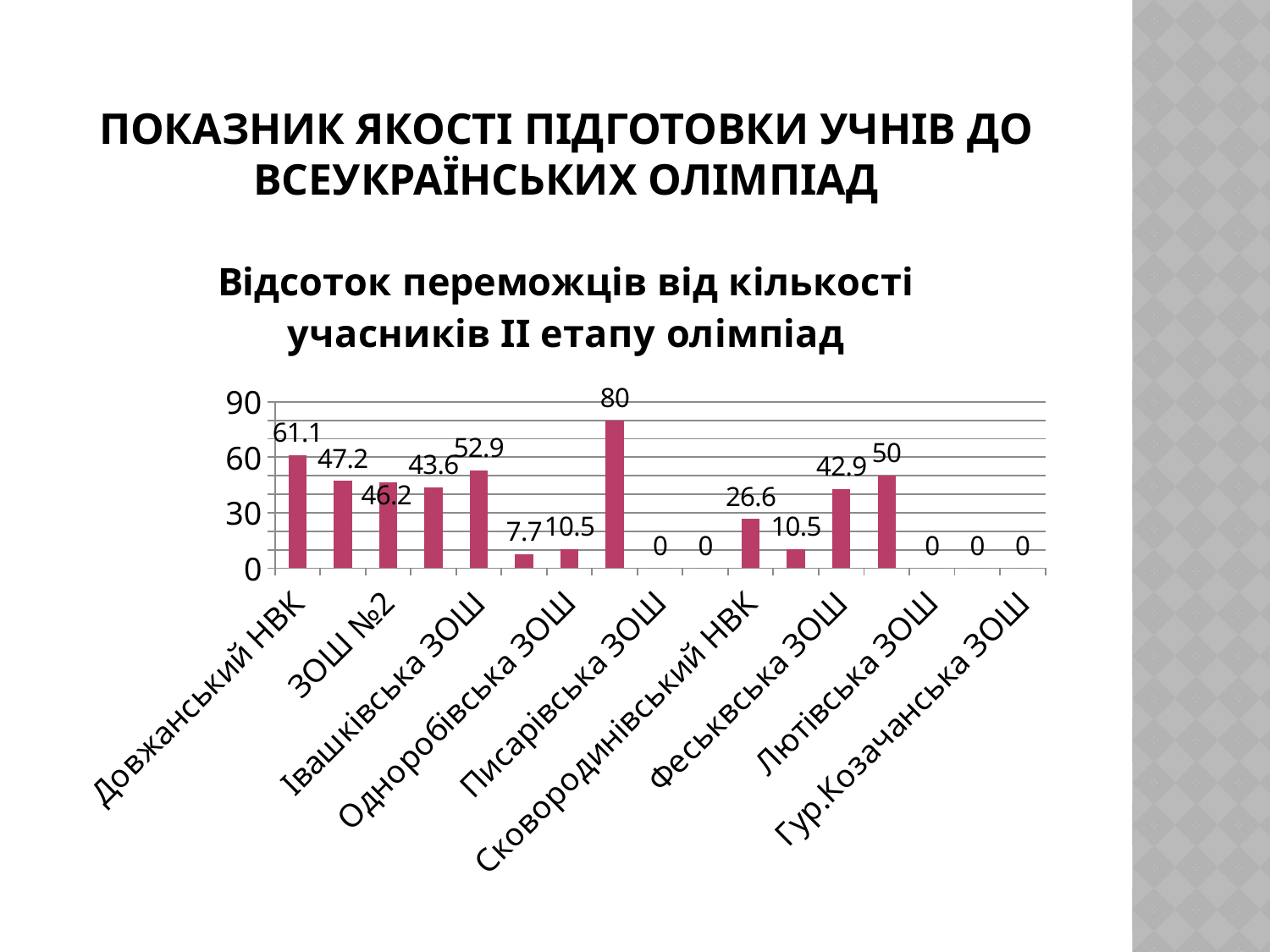
What type of chart is shown on the slide? bar chart What is the value for Феськівська ЗОШ? 42.9 What is the value for Гур.Козачанська ЗОШ? 0 What is the highest value shown in the chart? 80 How many bars are plotted in the chart? 17 What is the difference between the values for Довжанський НВК and Івашківська ЗОШ? 8.2 What is the value for Сковородинівський НВК? 26.6 What is the value for Довжанський НВК? 61.1 Is the value for Сковородинівський НВК greater or less than 30? less What is the title of the chart? Відсоток переможців від кількості учасників ІІ етапу олімпіад What is the value for Івашківська ЗОШ? 52.9 Which is larger, the value for Довжанський НВК or the value for Феськівська ЗОШ? Довжанський НВК